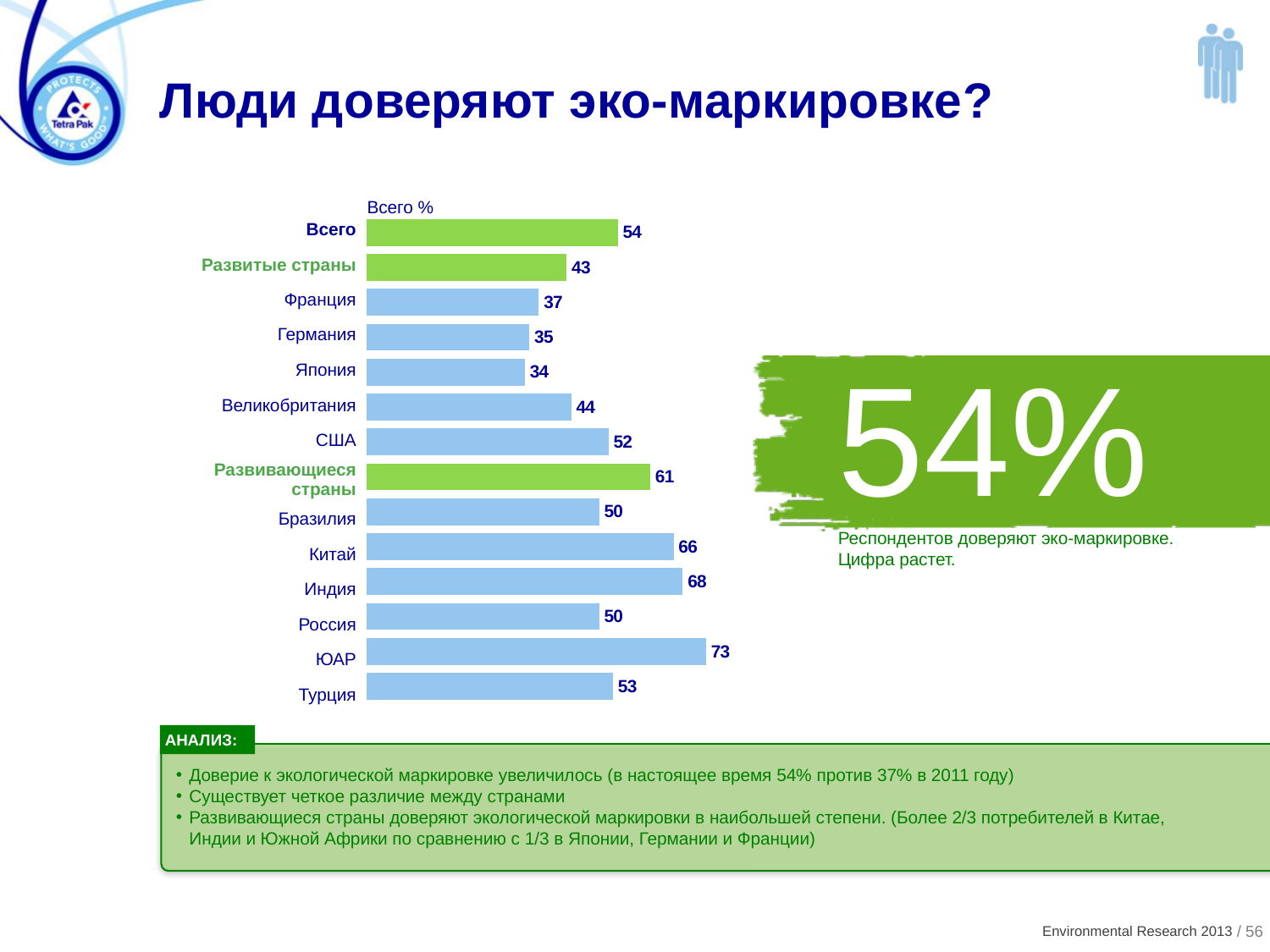
How many categories are shown in the chart? 14 What is the difference between the values for Развивающиеся страны and Развитые страны? 18 What is the value for Япония? 34 Which is larger, the value for Китай or the value for США? Китай Which category has the lowest value? Япония What is the value for ЮАР? 73 What is the difference between the values for Индия and Германия? 33 What is the value for Всего? 54 Which category has the highest value? ЮАР What is the value for Развивающиеся страны? 61 What kind of chart is shown on the slide? Bar chart What is the title of the chart? Всего %